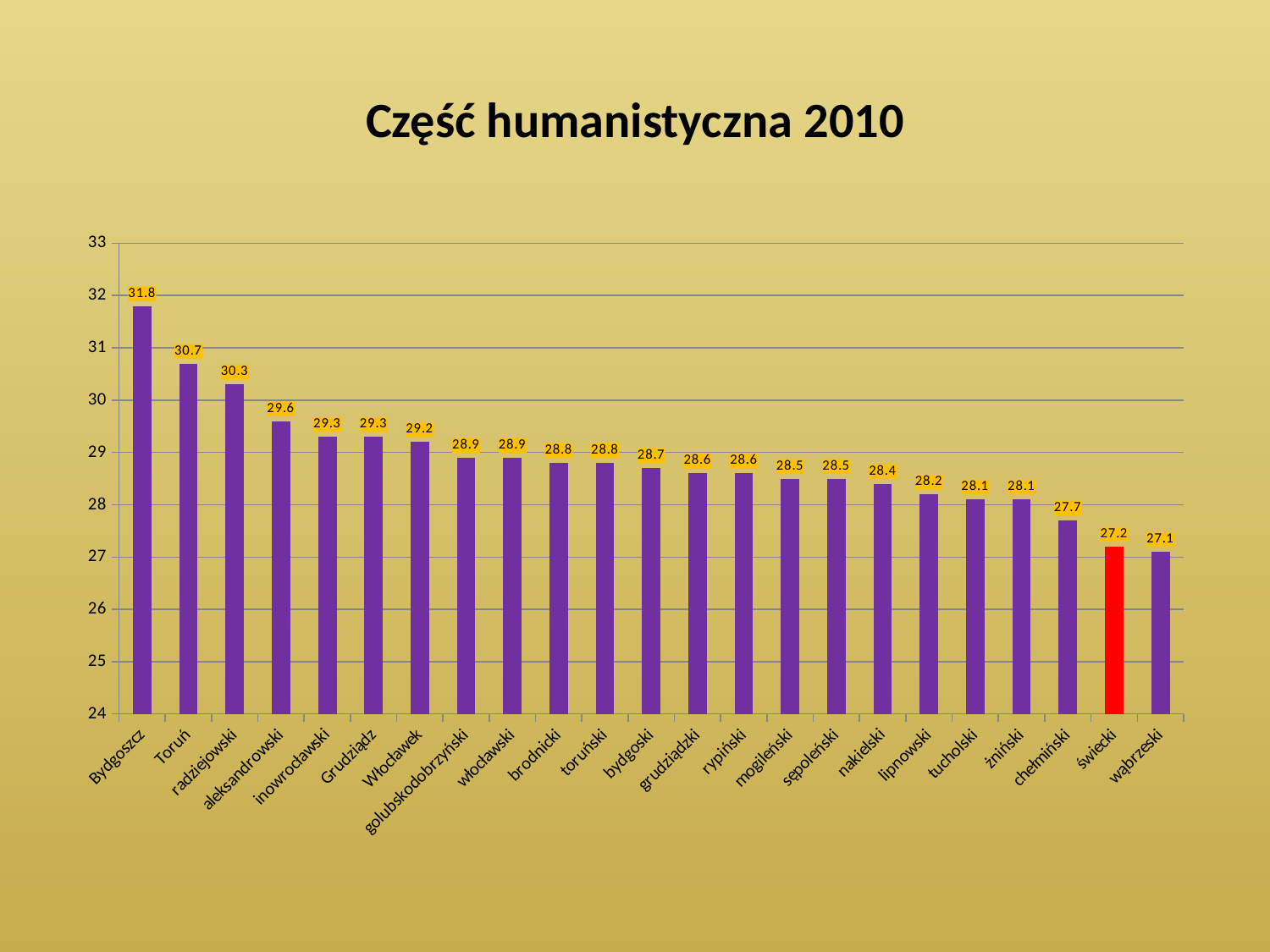
Which category has the lowest value? wąbrzeski Which is larger, the value for radziejowski or the value for aleksandrowski? radziejowski Which category has the highest value? Bydgoszcz What is the value for Grudziądz? 29.3 How many categories are shown on the x axis? 23 What is the value for Bydgoszcz? 31.8 Do the values rise or fall from left to right along the x axis? fall What is the value for chełmiński? 27.7 What is the difference between the values for Bydgoszcz and Toruń? 1.1 What kind of chart is shown on the slide? bar chart What is the value for świecki? 27.2 Which category's bar is coloured red? świecki